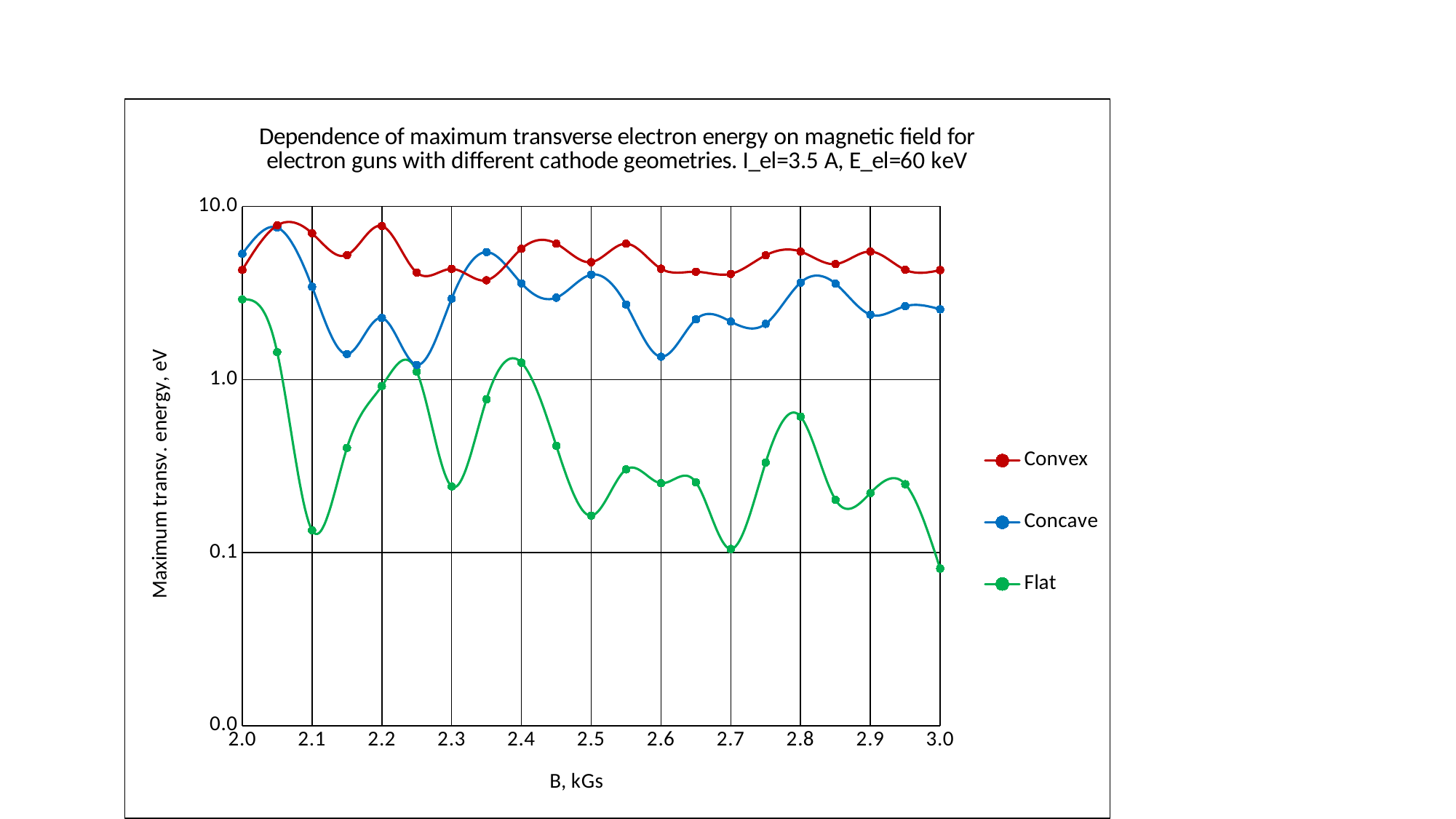
Is the value for Flat at B = 3.0 kGs greater or less than 0.1? less What is the label of the x axis? B, kGs At B = 2.6 kGs, which is larger, the Convex value or the Concave value? Convex Does the Flat series overall rise or fall from B = 2.0 kGs to B = 3.0 kGs? fall Is the value for Concave at B = 2.6 kGs greater or less than 1.0? greater Which series has the lowest value at B = 3.0 kGs? Flat Which colour is used for the Flat series? green What kind of chart is shown on the slide? line chart At B = 2.0 kGs, which is larger, the Convex value or the Concave value? Concave Is the value for Flat at B = 2.0 kGs greater or less than 1.0? greater How many series does the legend list? 3